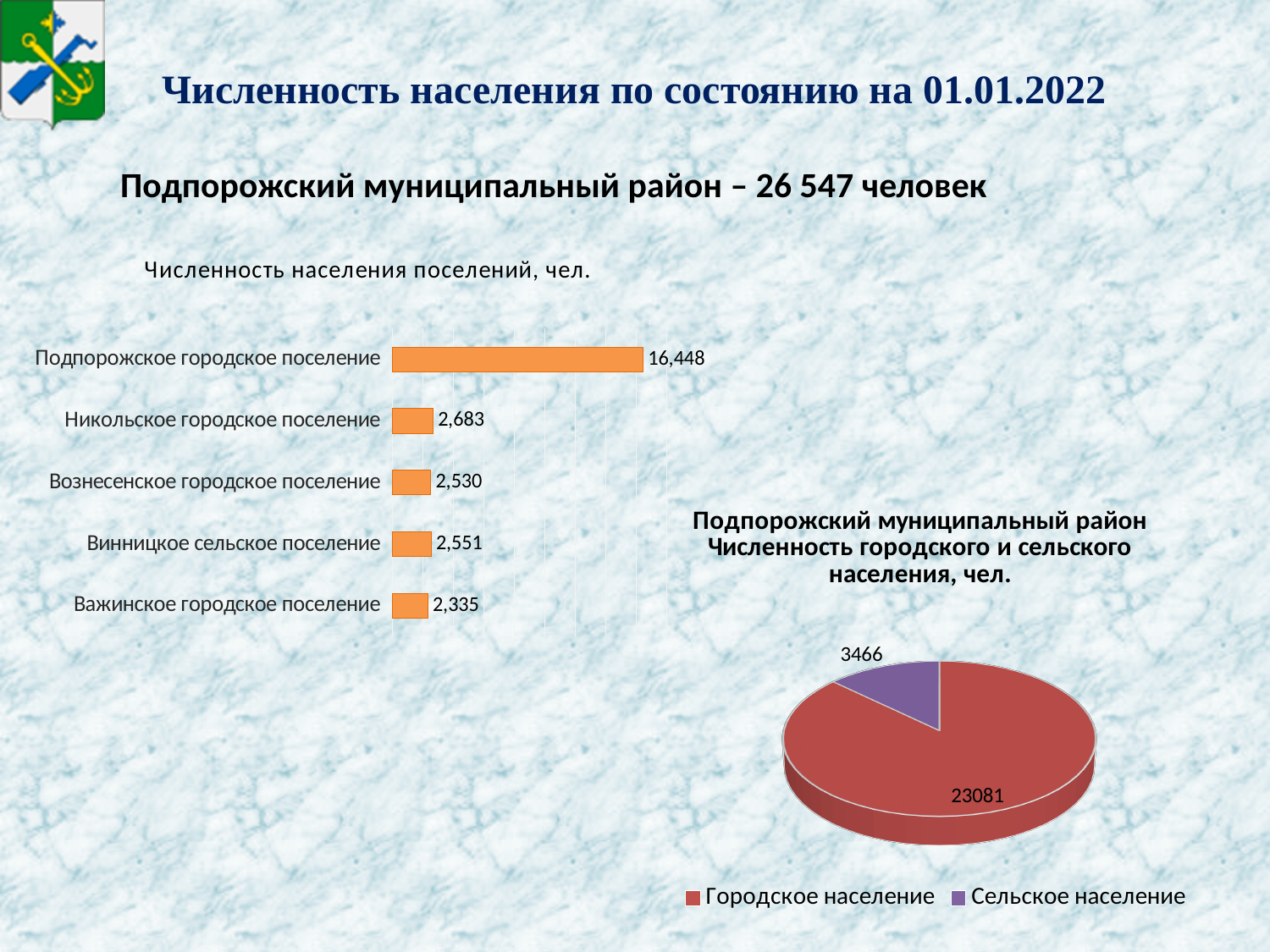
In the pie chart on the right, what is the value for Городское население? 23081 In the bar chart 'Численность населения поселений, чел.', what is the value for Подпорожское городское поселение? 16,448 In the bar chart 'Численность населения поселений, чел.', which settlement has the lowest population? Важинское городское поселение How many settlements are shown in the bar chart 'Численность населения поселений, чел.'? 5 In the bar chart 'Численность населения поселений, чел.', what is the value for Важинское городское поселение? 2,335 In the bar chart 'Численность населения поселений, чел.', which is larger: Винницкое сельское поселение or Вознесенское городское поселение? Винницкое сельское поселение How many series does the legend of the pie chart on the right list? 2 In the pie chart on the right, what colour is the Сельское население slice? purple What kind of chart is 'Численность населения поселений, чел.'? bar chart In the pie chart on the right, what is the value for Сельское население? 3466 In the bar chart 'Численность населения поселений, чел.', what is the difference between Никольское городское поселение and Вознесенское городское поселение? 153 In the bar chart 'Численность населения поселений, чел.', which settlement has the highest population? Подпорожское городское поселение